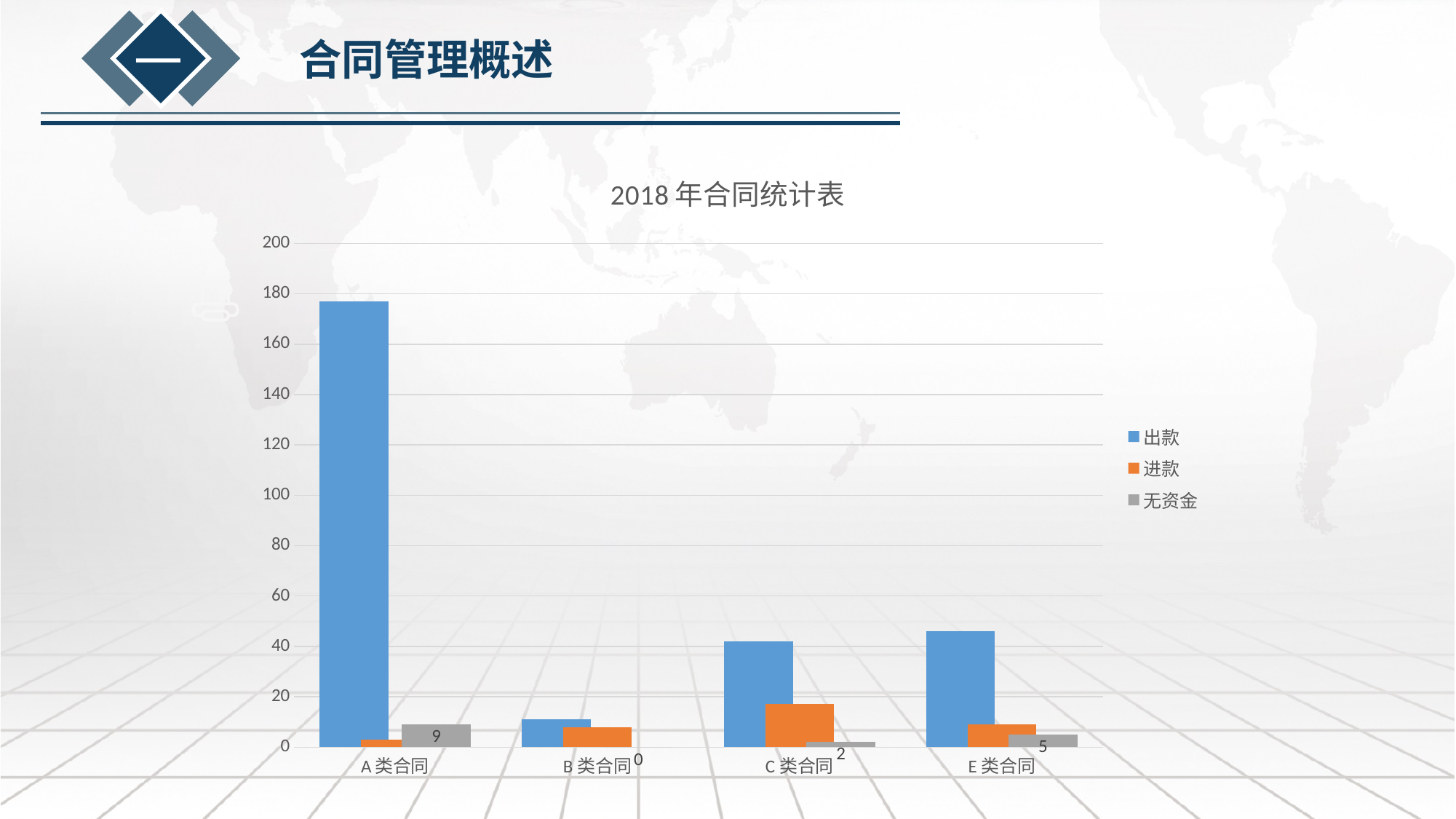
How many categories are shown on the x axis of the chart? 4 What is the 无资金 value for B 类合同? 0 How many series does the chart's legend list? 3 What is the 无资金 value for E 类合同? 5 Is the 出款 value for C 类合同 greater or less than 60? less What kind of chart is shown on the slide? bar chart What is the 无资金 value for A 类合同? 9 Which category has the highest 出款 value? A 类合同 What is the difference between the 无资金 values for A 类合同 and E 类合同? 4 Which category has the lowest 无资金 value? B 类合同 What is the title of the chart? 2018 年合同统计表 Is the 出款 value for A 类合同 greater or less than 160? greater